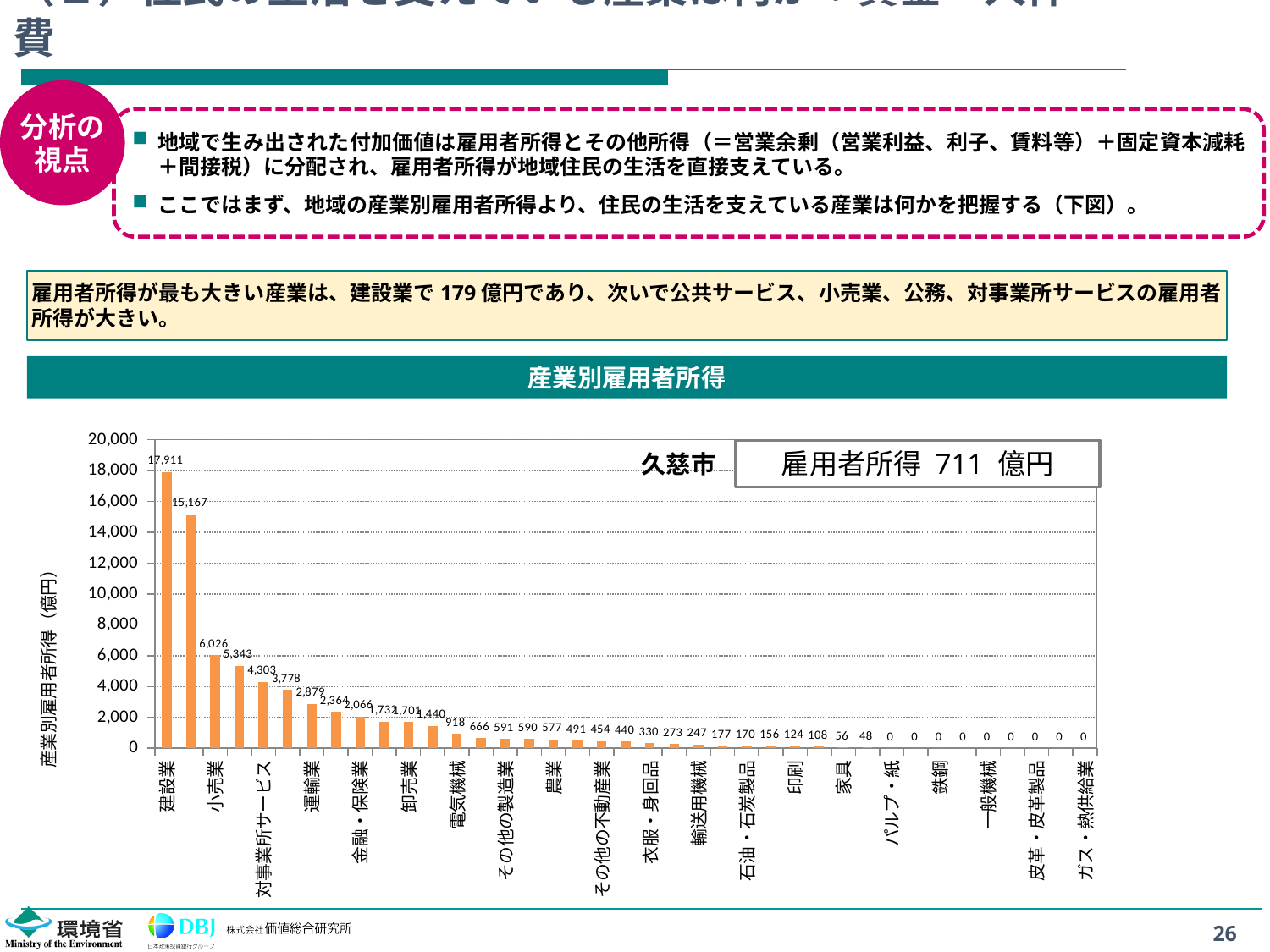
Which is larger in the 産業別雇用者所得 chart, 対事業所サービス or 運輸業? 対事業所サービス Do the values in the 産業別雇用者所得 chart rise or fall from left to right along the x axis? fall What total 雇用者所得 for 久慈市 is shown in the box on the 産業別雇用者所得 chart? 711 億円 Which industry has the highest value in the 産業別雇用者所得 chart? 建設業 What kind of chart is the 産業別雇用者所得 chart? bar chart What is the y-axis label of the 産業別雇用者所得 chart? 産業別雇用者所得（億円） What is the value for 運輸業 in the 産業別雇用者所得 chart? 2,879 What is the difference between the values for 建設業 and 小売業 in the 産業別雇用者所得 chart? 11,885 What is the value for 印刷 in the 産業別雇用者所得 chart? 124 What is the value for 建設業 in the 産業別雇用者所得 chart? 17,911 What is the value for 小売業 in the 産業別雇用者所得 chart? 6,026 Is the value for 電気機械 in the 産業別雇用者所得 chart greater or less than 2,000? less